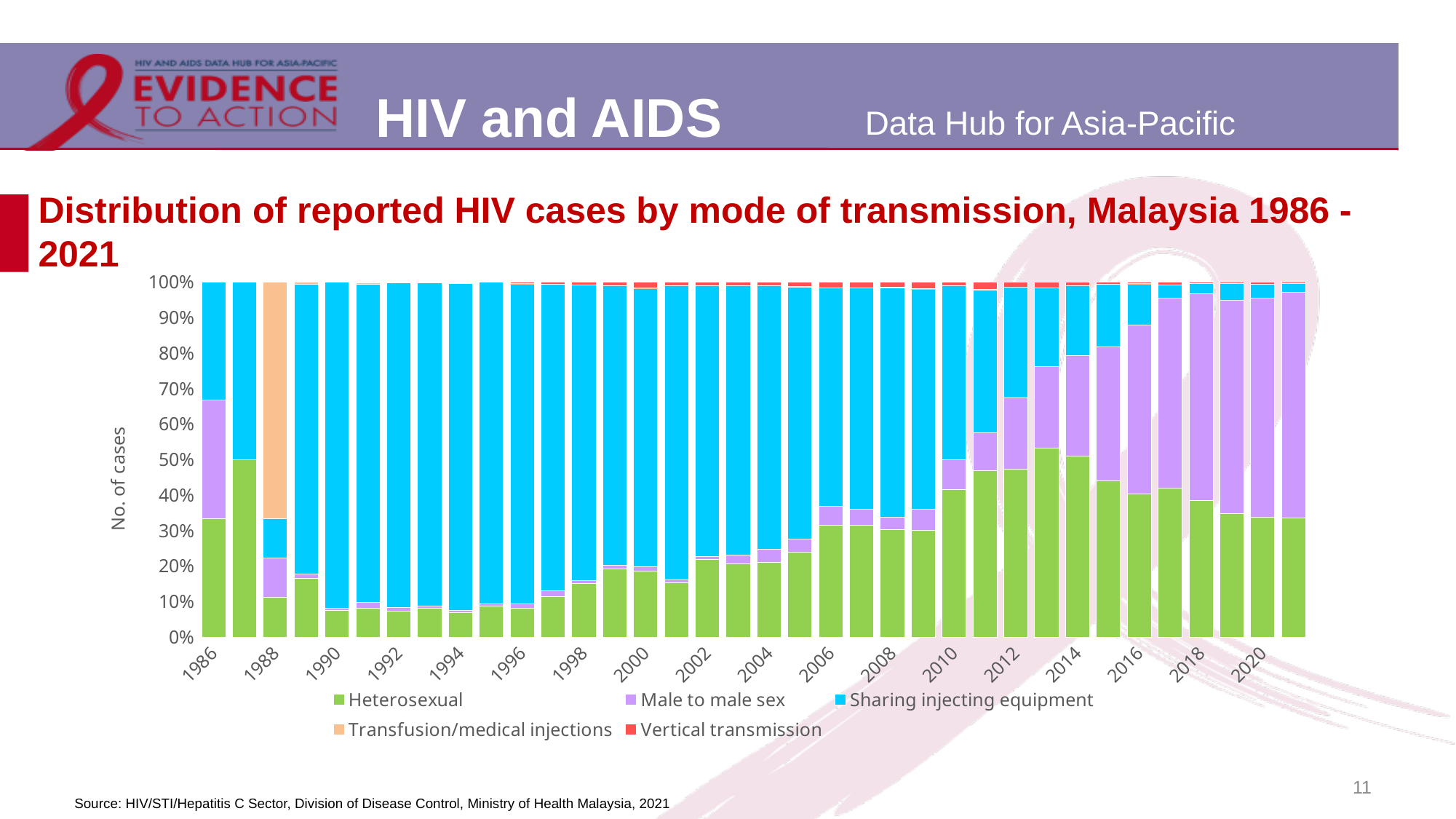
Which year has a larger Heterosexual share, 2010 or 2013? 2013 Which year has a larger Heterosexual share, 1986 or 1987? 1987 Is the Sharing injecting equipment share in 1990 greater or less than 80%? greater How many series does the legend list? 5 Which colour represents Sharing injecting equipment in the legend? Blue What is the title of the chart? Distribution of reported HIV cases by mode of transmission, Malaysia 1986 - 2021 Does the Sharing injecting equipment share rise or fall from 2010 to 2021? Fall Is the Male to male sex share in 2021 greater or less than 50%? greater How many years (bars) are plotted in the chart? 36 Is the Transfusion/medical injections share in 1988 greater or less than 60%? greater What kind of chart is shown on the slide? Stacked bar chart